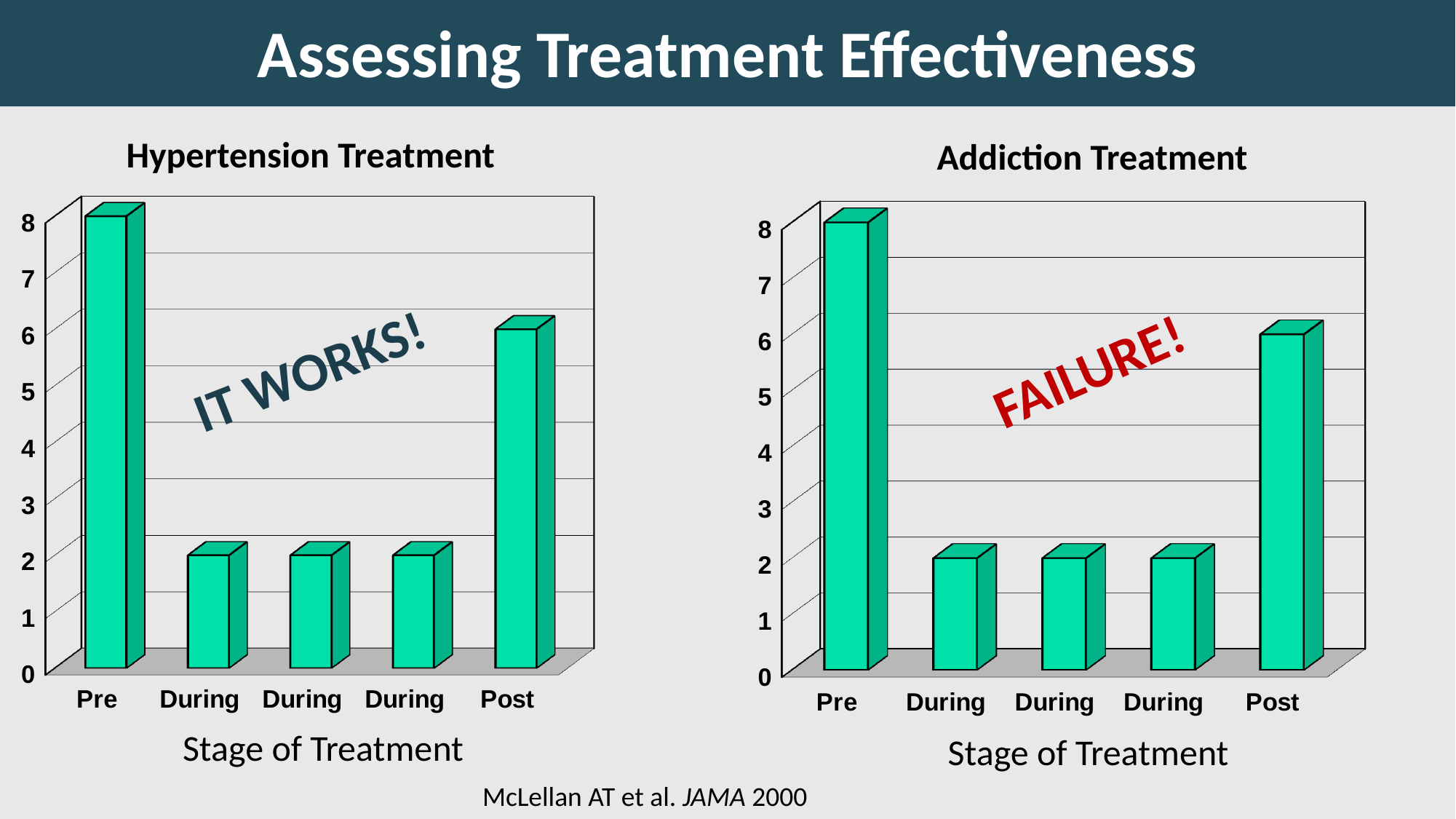
How many bars are shown in the Hypertension Treatment chart? 5 What kind of chart is the Addiction Treatment chart? Bar chart What text is overlaid on the Addiction Treatment chart? FAILURE! What is the x-axis label on the Addiction Treatment chart? Stage of Treatment In the Hypertension Treatment chart, what is the difference between the Pre and Post values? 2 In the Hypertension Treatment chart, what is the value for Pre? 8 In the Addiction Treatment chart, which is larger, the Pre value or the Post value? Pre In the Addiction Treatment chart, what is the value for Post? 6 In the Addiction Treatment chart, what is the value for each During stage? 2 In the Addiction Treatment chart, is the value for Post greater or less than 5? greater In the Hypertension Treatment chart, what is the difference between the Post value and a During value? 4 In the Hypertension Treatment chart, which stage has the highest value? Pre